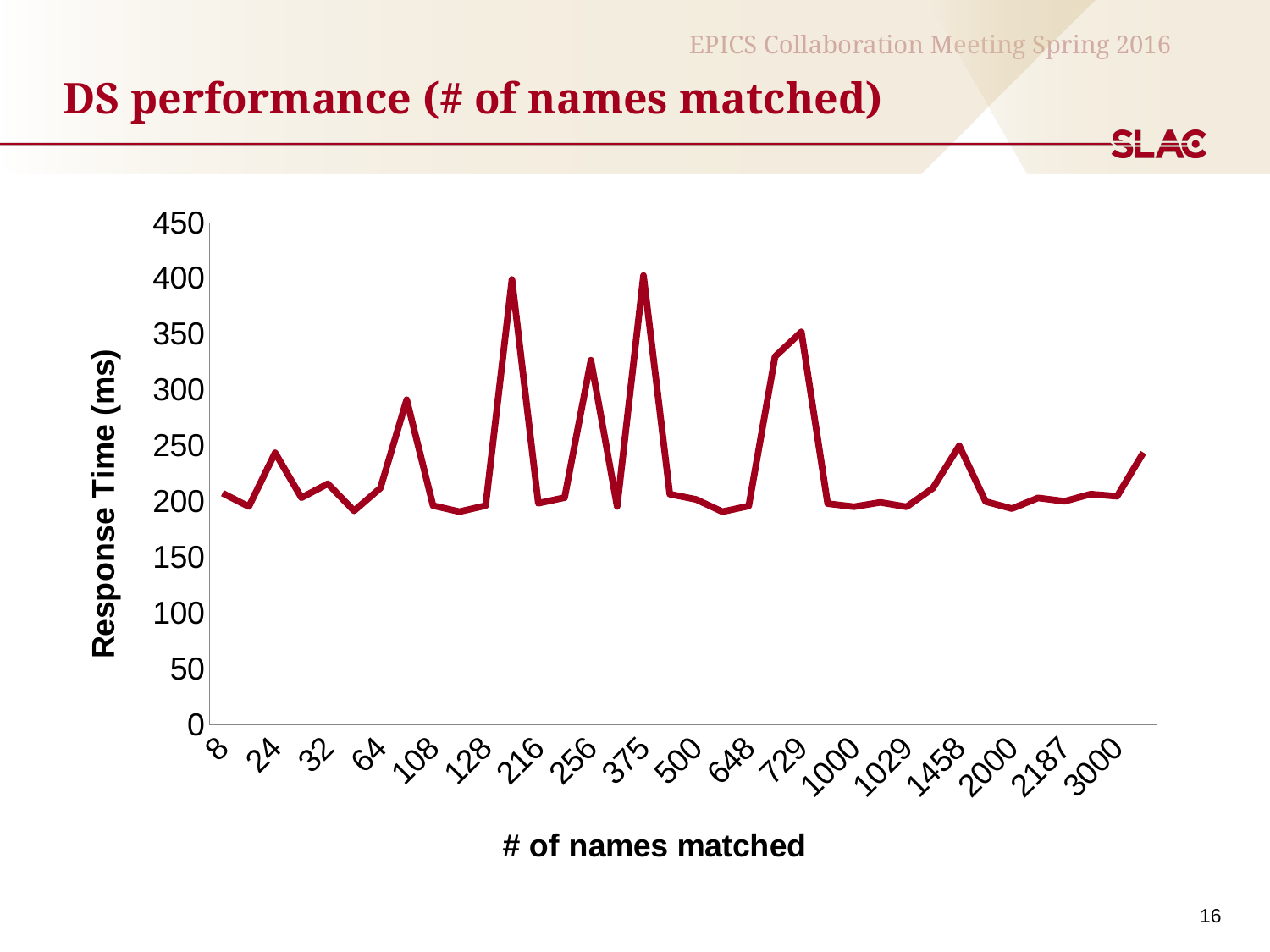
Is the response time for 256 names matched greater or less than 300? greater Is the response time for 64 names matched greater or less than 250? less Is the response time for 375 names matched greater or less than 350? greater What kind of chart is shown on the slide? line chart What is the label of the y axis? Response Time (ms) Which has the higher response time: 375 names matched or 729 names matched? 375 What is the label of the x axis? # of names matched